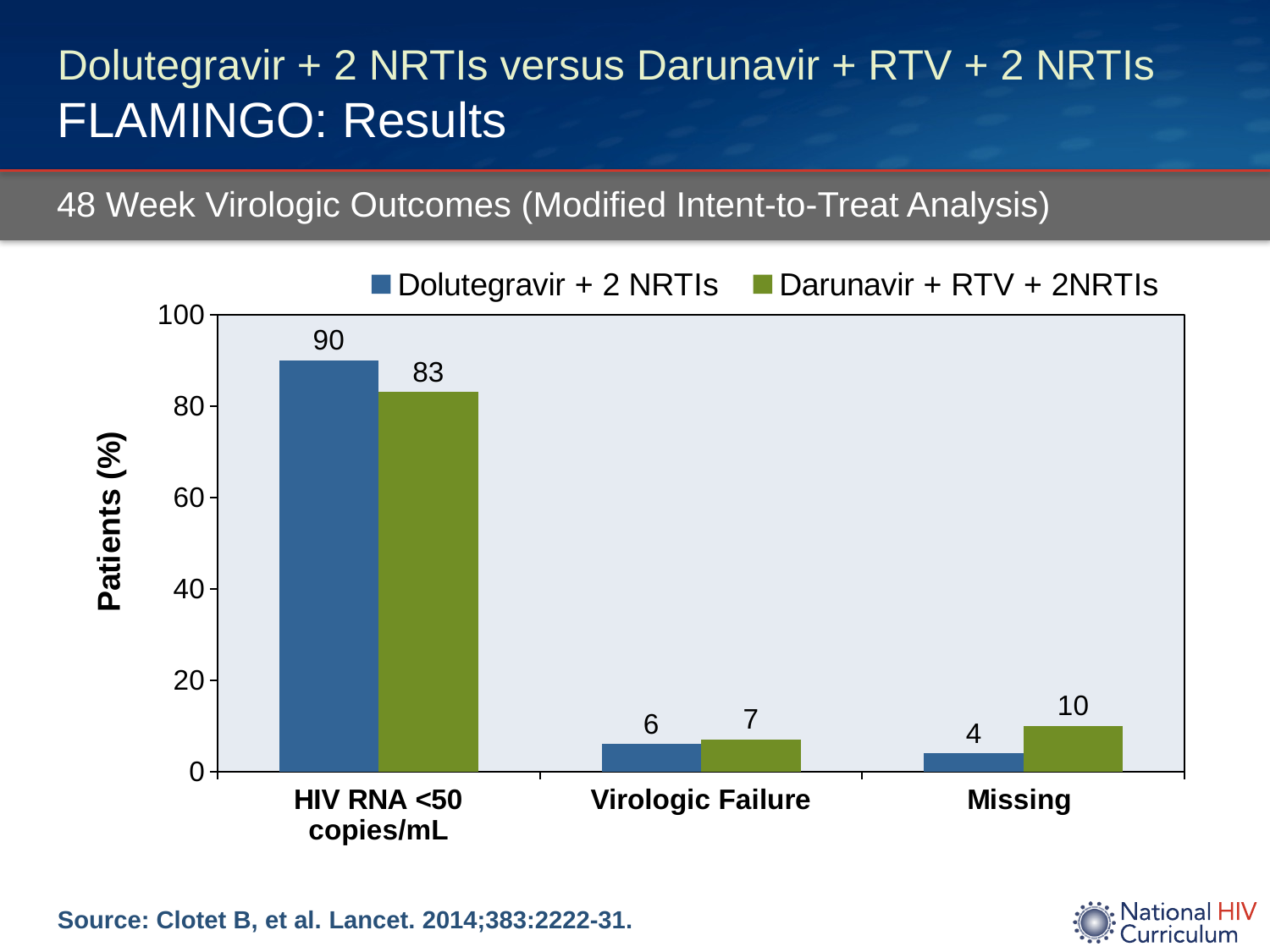
What is the Virologic Failure value for the Darunavir + RTV + 2NRTIs group? 7 How many categories are shown on the x axis? 3 What percentage of patients in the Darunavir + RTV + 2NRTIs group had HIV RNA <50 copies/mL? 83 What is the Missing value for the Dolutegravir + 2 NRTIs group? 4 Which category has the highest value for the Darunavir + RTV + 2NRTIs group? HIV RNA <50 copies/mL Which category has the lowest value for the Dolutegravir + 2 NRTIs group? Missing What is the difference between the two groups for HIV RNA <50 copies/mL? 7 Which group has the larger Missing value? Darunavir + RTV + 2NRTIs What percentage of patients in the Dolutegravir + 2 NRTIs group had HIV RNA <50 copies/mL? 90 How many series does the legend list? 2 What type of chart is shown on the slide? Bar chart What is the difference between the two groups in the Missing category? 6